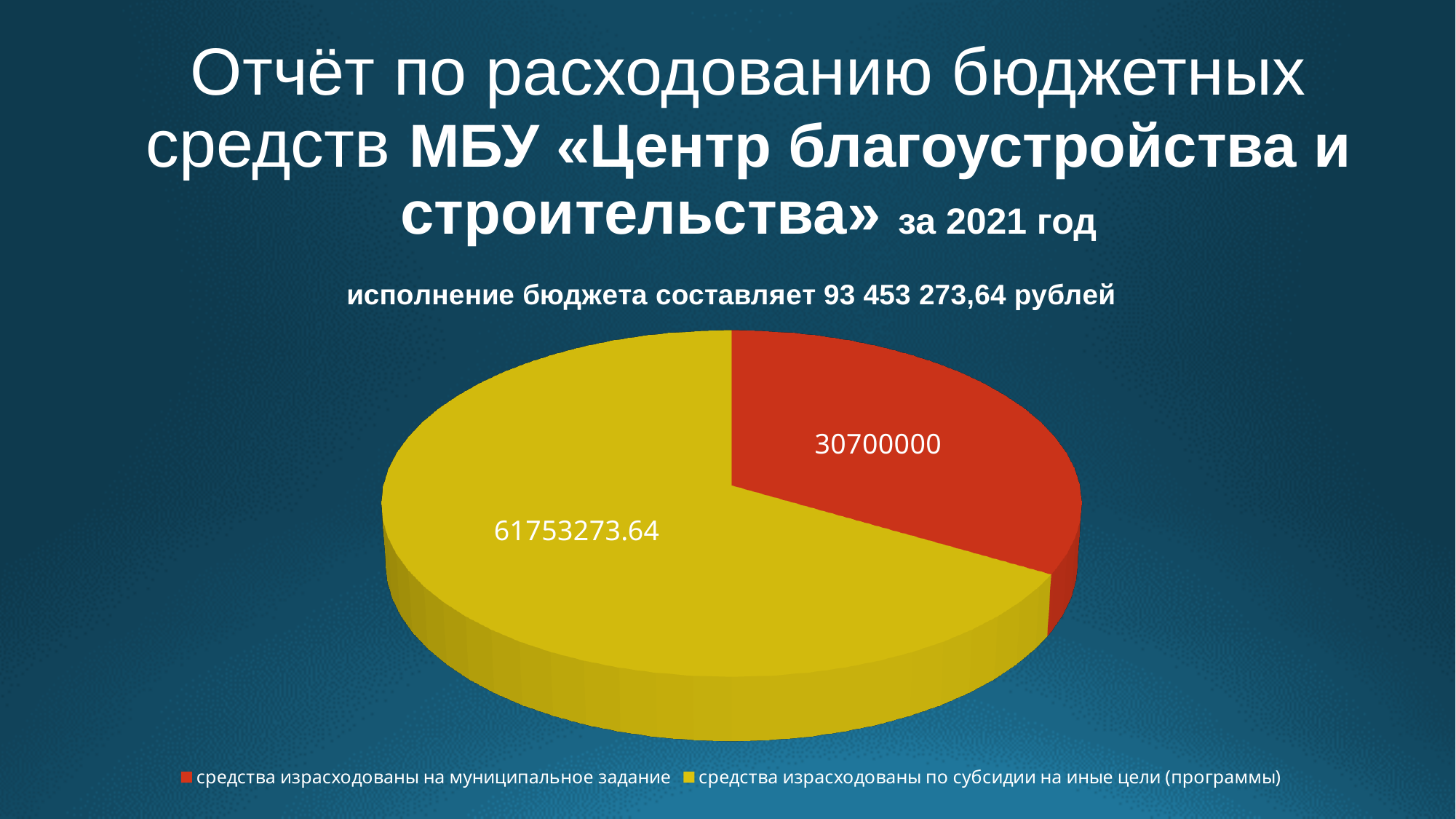
What kind of chart is shown on the slide? pie chart What is the total of the two values shown on the pie chart? 92453273.64 Which category has the largest slice of the pie? средства израсходованы по субсидии на иные цели (программы) What colour is the slice for "средства израсходованы на муниципальное задание"? red What is the difference between the value for "средства израсходованы по субсидии на иные цели (программы)" and the value for "средства израсходованы на муниципальное задание"? 31053273.64 Which category has the smallest slice of the pie? средства израсходованы на муниципальное задание What is the value for "средства израсходованы на муниципальное задание"? 30700000 What colour is the slice for "средства израсходованы по субсидии на иные цели (программы)"? yellow What is the value for "средства израсходованы по субсидии на иные цели (программы)"? 61753273.64 How many slices does the pie chart have? 2 How many entries does the legend of the pie chart list? 2 Which is larger: the value for "средства израсходованы на муниципальное задание" or the value for "средства израсходованы по субсидии на иные цели (программы)"? средства израсходованы по субсидии на иные цели (программы)